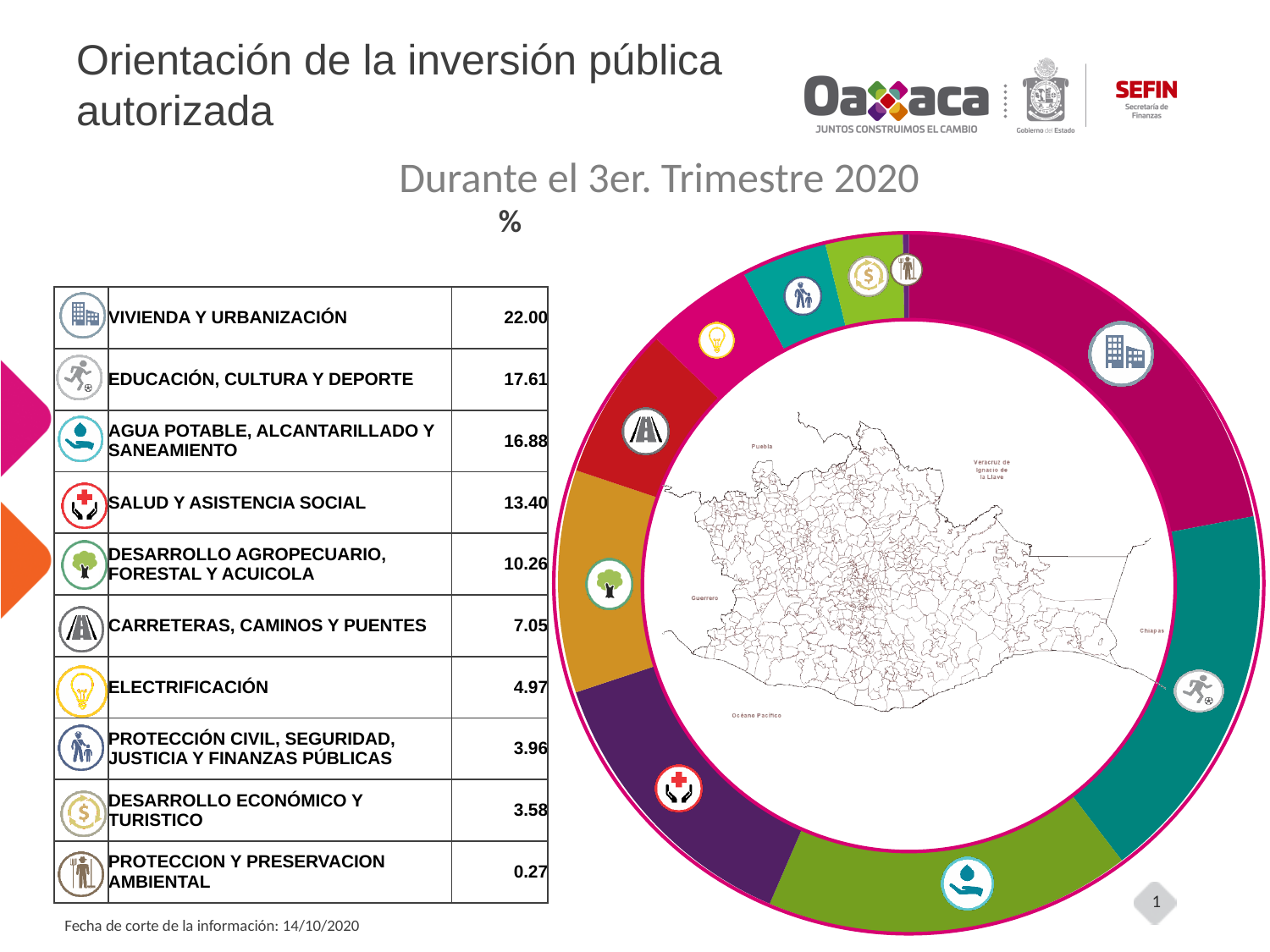
What value is shown for CARRETERAS, CAMINOS Y PUENTES? 7.05 What percentage of the authorized public investment goes to VIVIENDA Y URBANIZACIÓN? 22.00 Which is larger, the value for DESARROLLO AGROPECUARIO, FORESTAL Y ACUICOLA or the value for CARRETERAS, CAMINOS Y PUENTES? DESARROLLO AGROPECUARIO, FORESTAL Y ACUICOLA What is the difference between the values for AGUA POTABLE, ALCANTARILLADO Y SANEAMIENTO and SALUD Y ASISTENCIA SOCIAL? 3.48 What kind of chart is shown on the slide? Donut (pie) chart How many categories are shown in the chart? 10 What is the cut-off date of the information shown on the slide? 14/10/2020 Which category has the highest share of the authorized public investment? VIVIENDA Y URBANIZACIÓN What value is shown for ELECTRIFICACIÓN? 4.97 What value is shown for SALUD Y ASISTENCIA SOCIAL? 13.40 Which category has the lowest share of the authorized public investment? PROTECCION Y PRESERVACION AMBIENTAL What is the difference between the values for VIVIENDA Y URBANIZACIÓN and EDUCACIÓN, CULTURA Y DEPORTE? 4.39